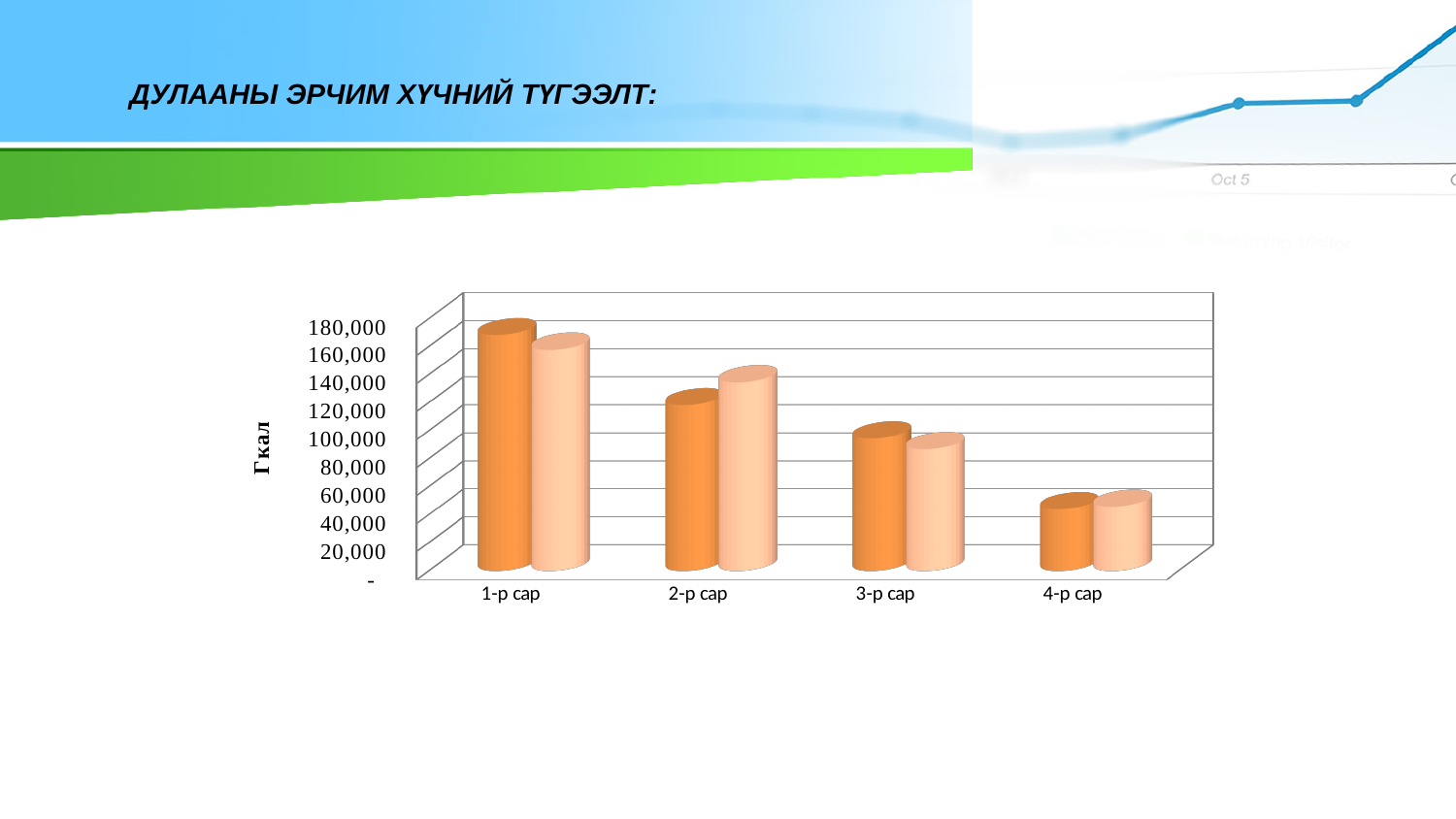
For 2-р сар, which bar is taller, the dark orange one or the light peach one? light peach Which category has the lowest value for the light peach bars? 4-р сар Is the dark orange value for 1-р сар greater or less than 140,000? greater Which category has the highest value for the dark orange bars? 1-р сар Is the light peach value for 2-р сар greater or less than 120,000? greater What is the label on the vertical axis of the chart? Гкал Is the dark orange value for 4-р сар greater or less than 60,000? less Which category has the lowest value for the dark orange bars? 4-р сар Do the dark orange bars rise or fall from 1-р сар to 4-р сар? fall What kind of chart is shown on the slide? bar chart How many categories are shown on the x axis of the chart? 4 Which category has the highest value for the light peach bars? 1-р сар